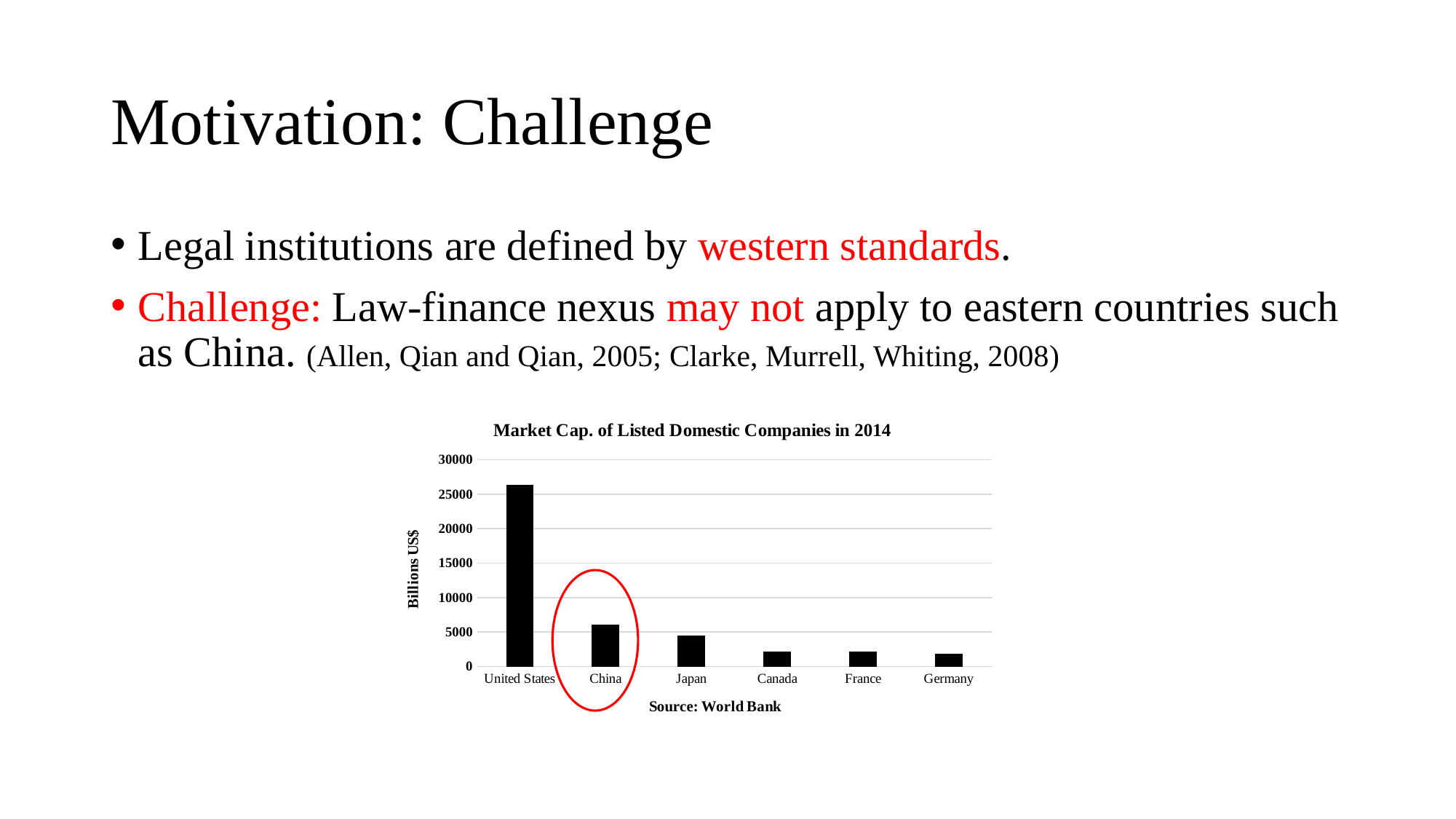
Is the value for the United States greater or less than 20000? greater Is the value for Japan greater or less than 5000? less What kind of chart is shown on the slide? bar chart Which has a larger market cap, China or Japan? China What is the title of the chart? Market Cap. of Listed Domestic Companies in 2014 How many countries are shown on the x axis of the chart? 6 Is the value for Germany greater or less than 5000? less Which has a larger market cap, the United States or China? United States What is the label on the y axis of the chart? Billions US$ Which country has the highest market cap in the chart? United States